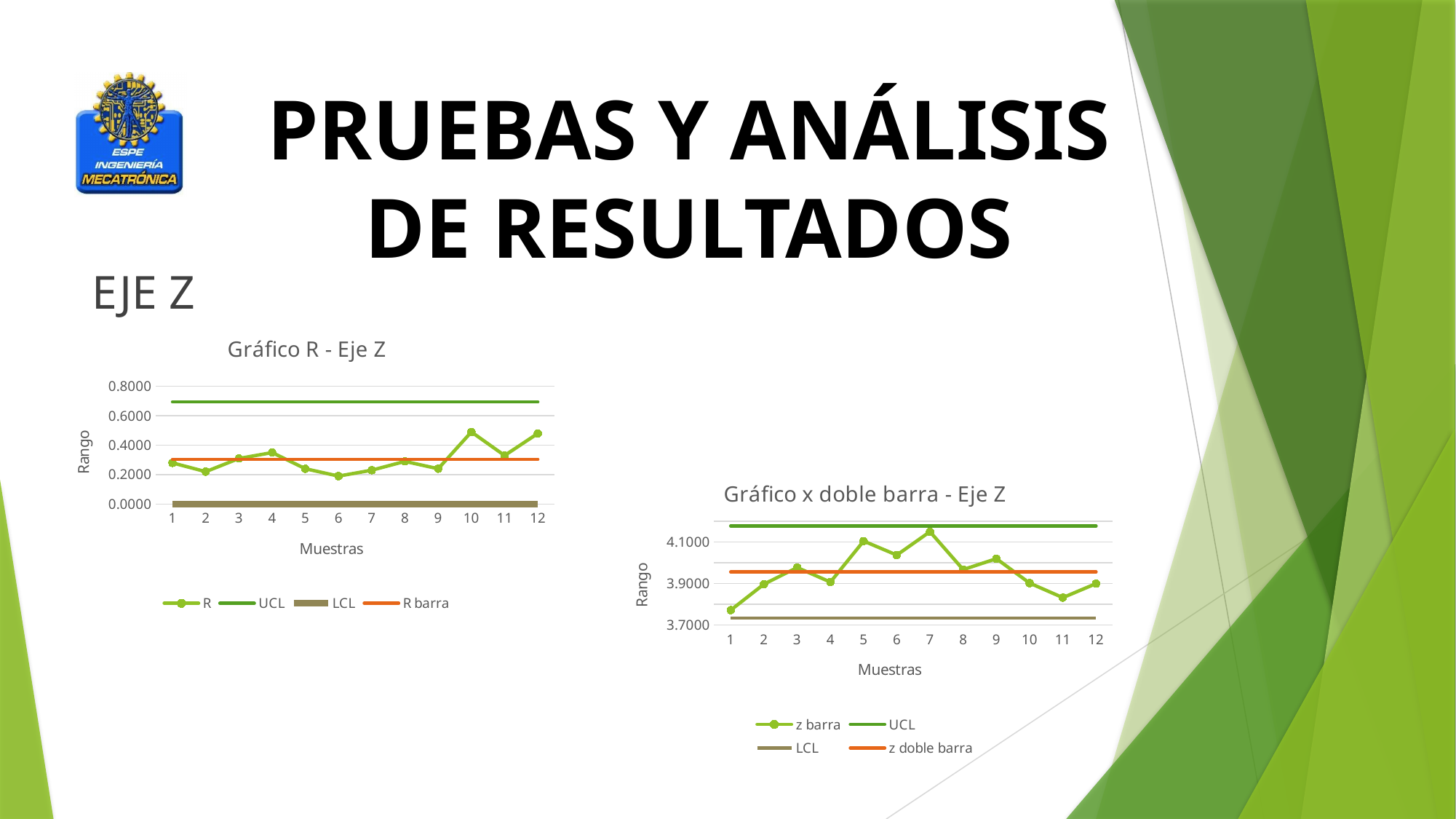
What is the x-axis title of "Gráfico x doble barra - Eje Z"? Muestras How many samples (Muestras) are plotted on the x axis of "Gráfico R - Eje Z"? 12 In "Gráfico x doble barra - Eje Z", is the z barra value for sample 1 greater or less than 3.9000? less In "Gráfico R - Eje Z", which of samples 10 and 6 has the larger R value? sample 10 In "Gráfico R - Eje Z", is the UCL line greater or less than 0.6000? greater In "Gráfico R - Eje Z", is the R value for sample 2 greater or less than 0.4000? less In "Gráfico x doble barra - Eje Z", does the z barra value rise or fall from sample 1 to sample 3? rise In "Gráfico x doble barra - Eje Z", which sample has the lowest z barra value? 1 In "Gráfico x doble barra - Eje Z", which sample has the highest z barra value? 7 What type of chart is "Gráfico R - Eje Z"? line chart How many series does the legend of "Gráfico x doble barra - Eje Z" list? 4